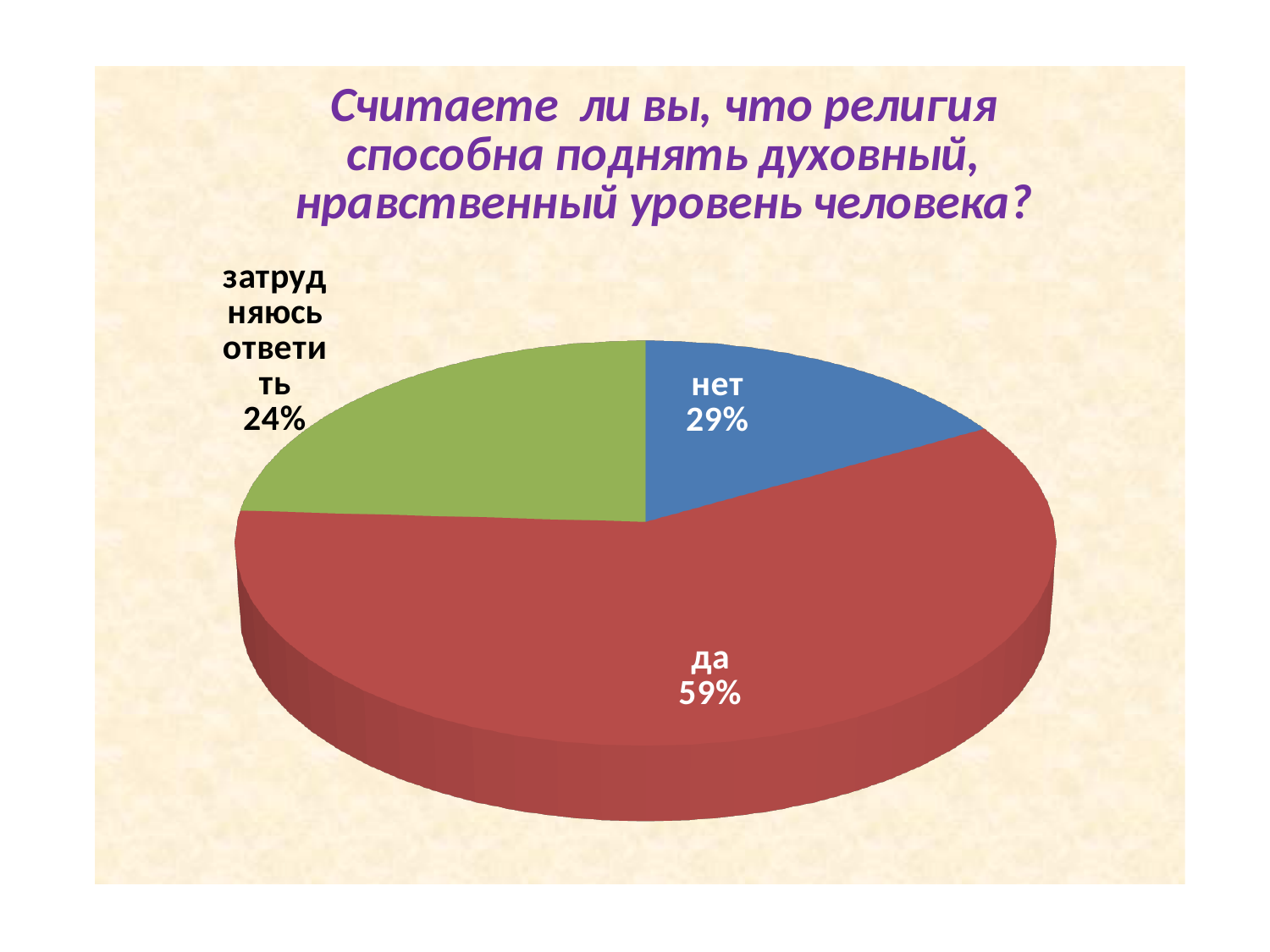
What colour is the "да" slice? red What kind of chart is shown on the slide? pie chart Which answer has the largest slice of the pie? да What percentage of respondents answered "да"? 59% What percentage of respondents answered "нет"? 29% What share of the pie does the "да" slice represent? 59% Which is larger, the share for "да" or the share for "нет"? да What is the difference in percentage points between the "да" and "нет" slices? 30 What is the difference in percentage points between the "нет" and "затрудняюсь ответить" slices? 5 How many slices does the pie chart have? 3 What question is the chart titled with? Считаете ли вы, что религия способна поднять духовный, нравственный уровень человека? What percentage is shown for the "затрудняюсь ответить" slice? 24%